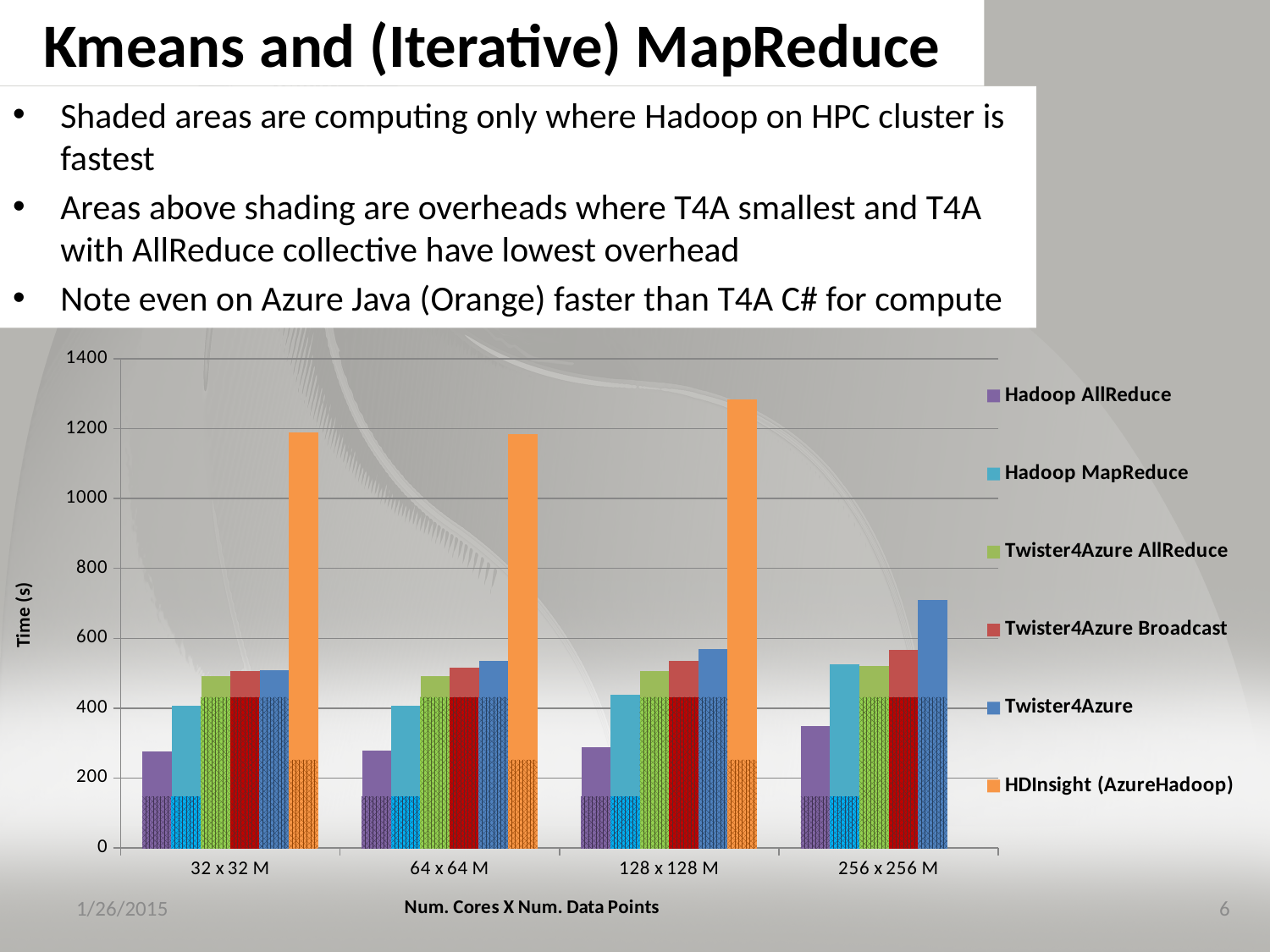
Is the value for Hadoop AllReduce at 32 x 32 M greater or less than 400? less Is the value for HDInsight (AzureHadoop) at 128 x 128 M greater or less than 1200? greater Is the value for Twister4Azure AllReduce at 64 x 64 M greater or less than 600? less Which series has the lowest value for the 32 x 32 M category? Hadoop AllReduce How many series does the chart's legend list? 6 For the 128 x 128 M category, which is larger: HDInsight (AzureHadoop) or Twister4Azure? HDInsight (AzureHadoop) Which series has the highest value for the 32 x 32 M category? HDInsight (AzureHadoop) What kind of chart is shown on the slide? bar chart What is the title of the chart's y axis? Time (s) How many categories are shown on the x axis of the chart? 4 Do the values for Twister4Azure rise or fall from 32 x 32 M to 256 x 256 M? rise